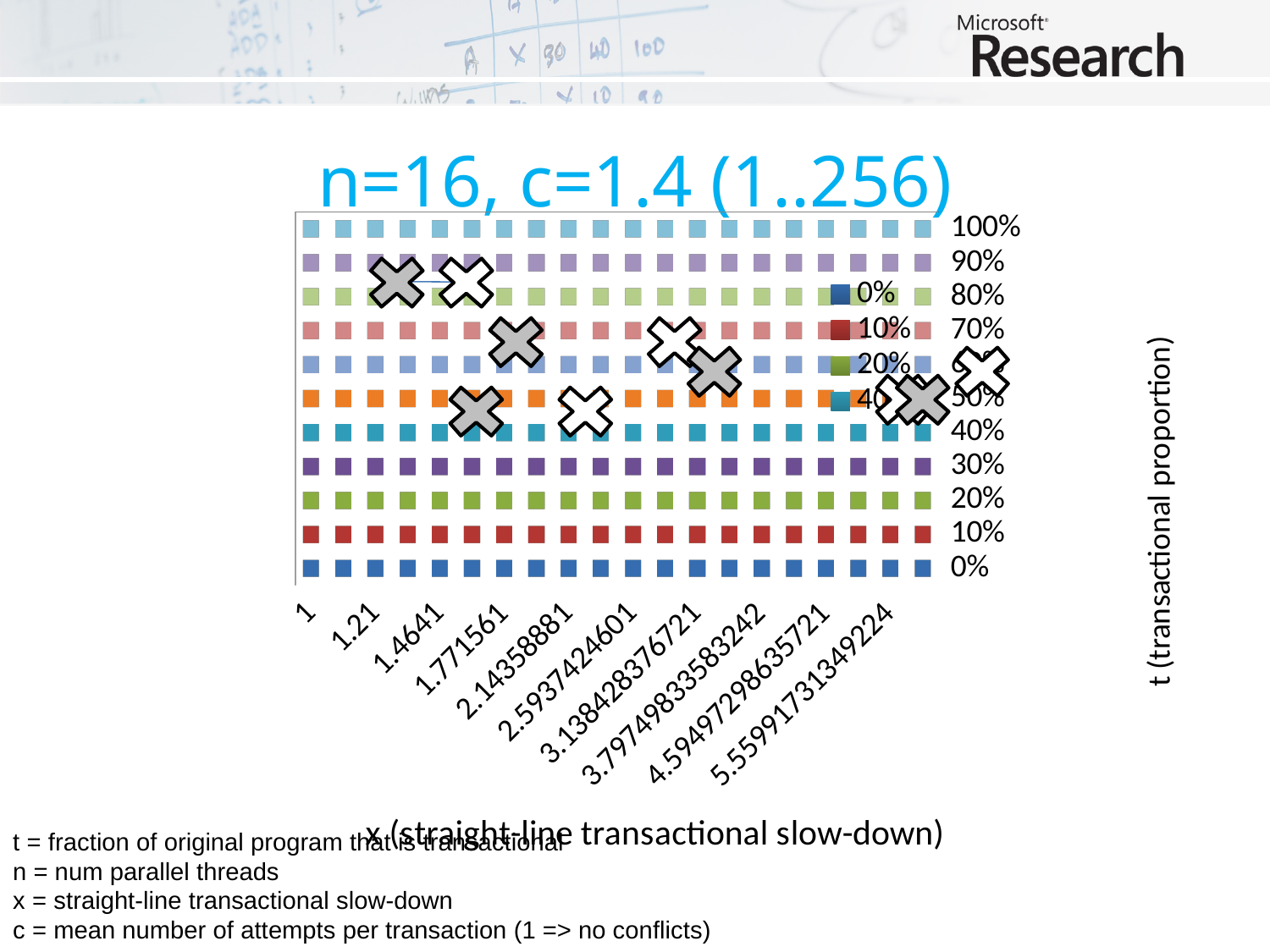
How many horizontal rows of markers (t levels from 0% to 100%) are plotted in the chart? 11 What is the highest t value labelled on the vertical axis? 100% What kind of chart is shown on the slide? scatter chart What is the lowest t value labelled on the vertical axis? 0% How many tick labels are shown along the x axis of the chart? 10 What is the title of the chart? n=16, c=1.4 (1..256) What is the first (leftmost) tick label on the x axis? 1 What is the second tick label on the x axis? 1.21 What is the title of the vertical axis on the right of the chart? t (transactional proportion)